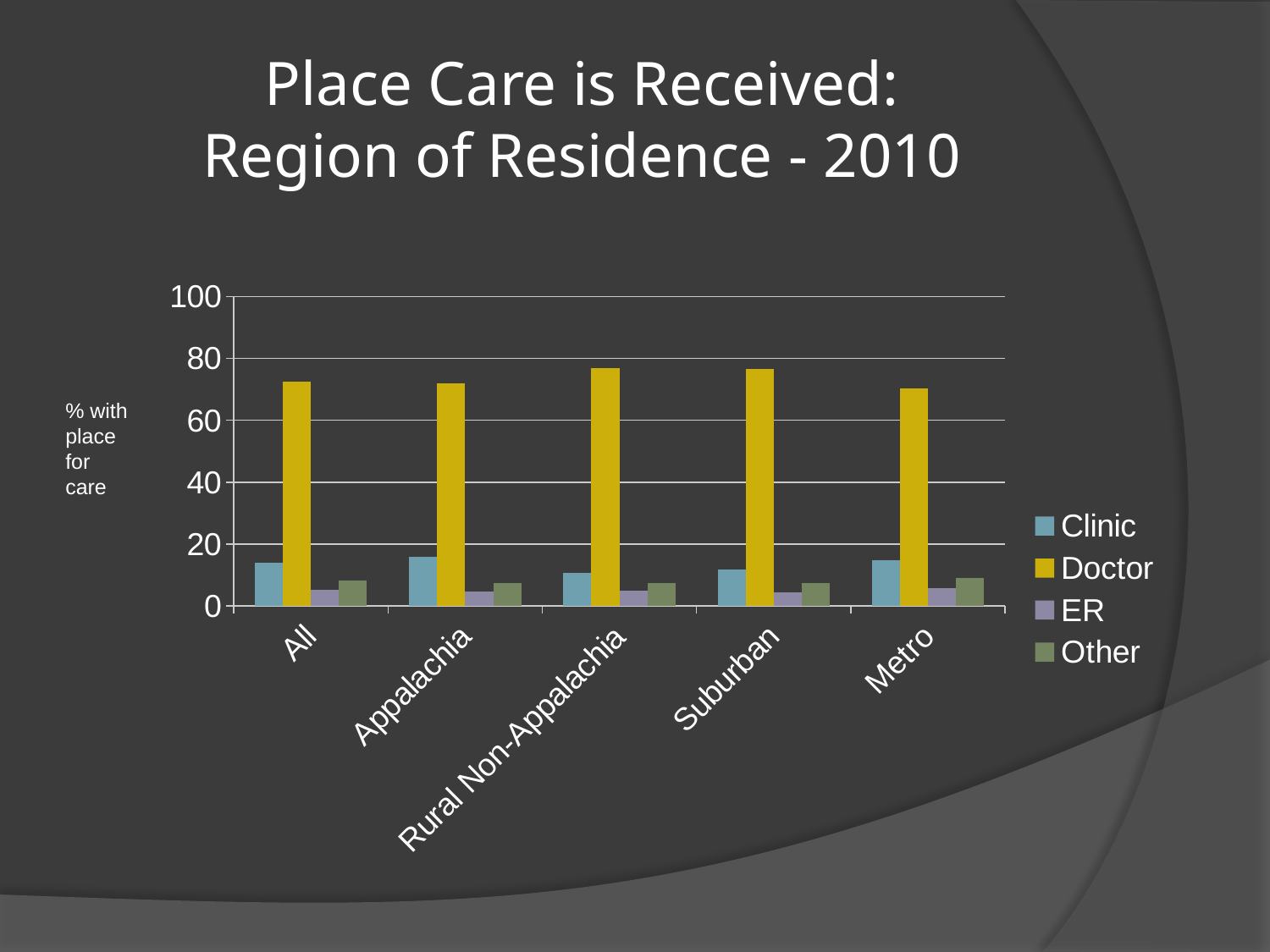
Is the Doctor value for All greater or less than 60? greater Which series has the lowest value for the All category? ER Is the ER value for Rural Non-Appalachia greater or less than 20? less How many series does the legend list? 4 Is the Doctor value for Metro greater or less than 80? less Which is larger for Metro, the Doctor value or the Clinic value? Doctor What is the title of the chart on the slide? Place Care is Received: Region of Residence - 2010 Which is larger for Appalachia, the Clinic value or the ER value? Clinic What kind of chart is shown on the slide? bar chart How many region categories are shown on the x axis? 5 Which series has the highest value for the Suburban category? Doctor